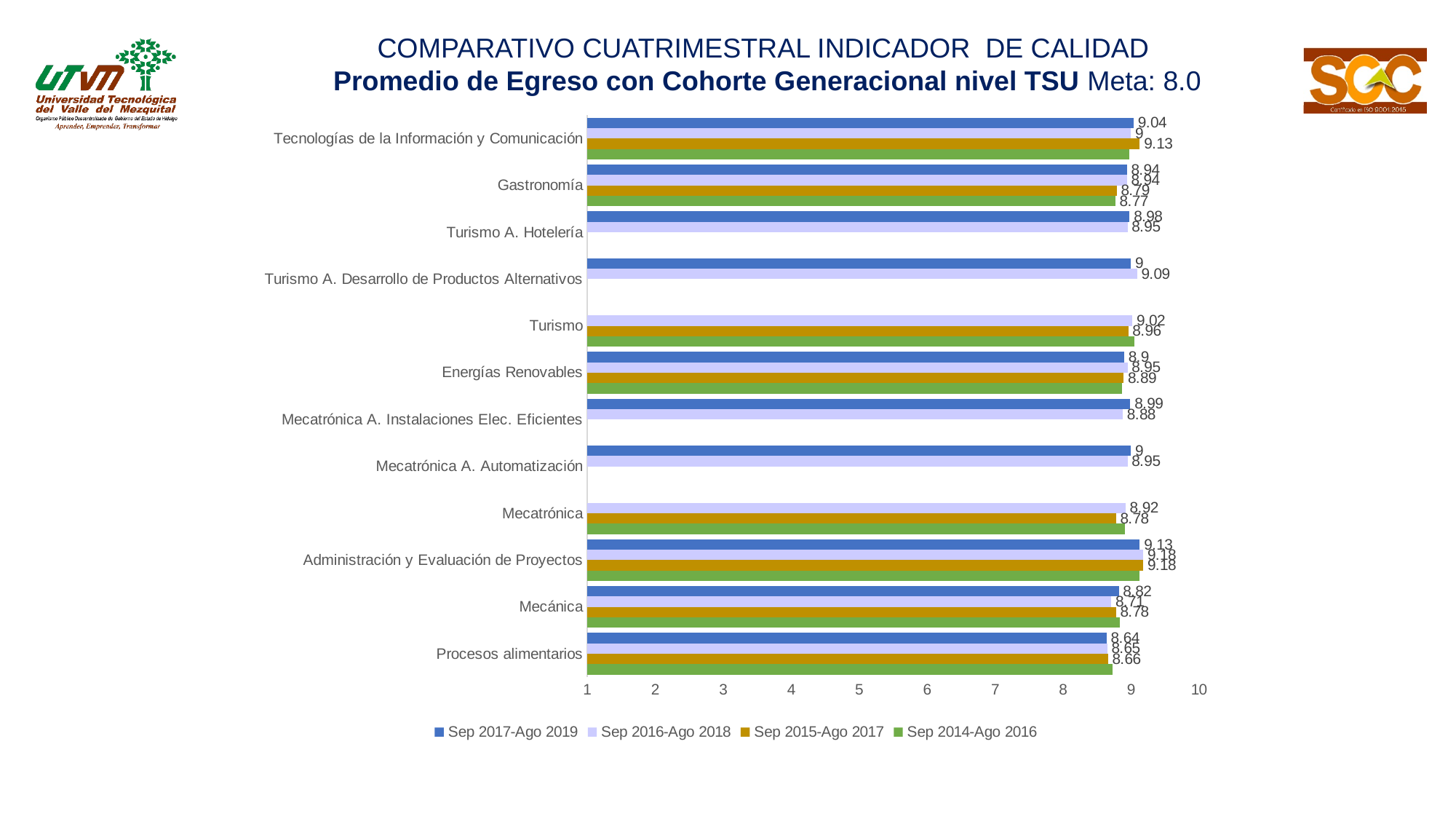
How many series does the legend list? 4 Which program has the highest value in the Sep 2017-Ago 2019 series? Administración y Evaluación de Proyectos What is the value for Tecnologías de la Información y Comunicación in the Sep 2015-Ago 2017 series? 9.13 How many programs (categories) are listed on the vertical axis? 12 What is the value for Turismo A. Desarrollo de Productos Alternativos in the Sep 2016-Ago 2018 series? 9.09 What is the value for Mecatrónica A. Instalaciones Elec. Eficientes in the Sep 2016-Ago 2018 series? 8.88 What target (Meta) value is stated in the chart title? 8.0 What is the value for Procesos alimentarios in the Sep 2017-Ago 2019 series? 8.64 For Mecánica, which is larger: the Sep 2017-Ago 2019 value or the Sep 2016-Ago 2018 value? Sep 2017-Ago 2019 Is the value for Procesos alimentarios in the Sep 2014-Ago 2016 series greater or less than 8? greater For Gastronomía, what is the difference between the Sep 2017-Ago 2019 value and the Sep 2014-Ago 2016 value? 0.17 What kind of chart is shown on the slide? Bar chart